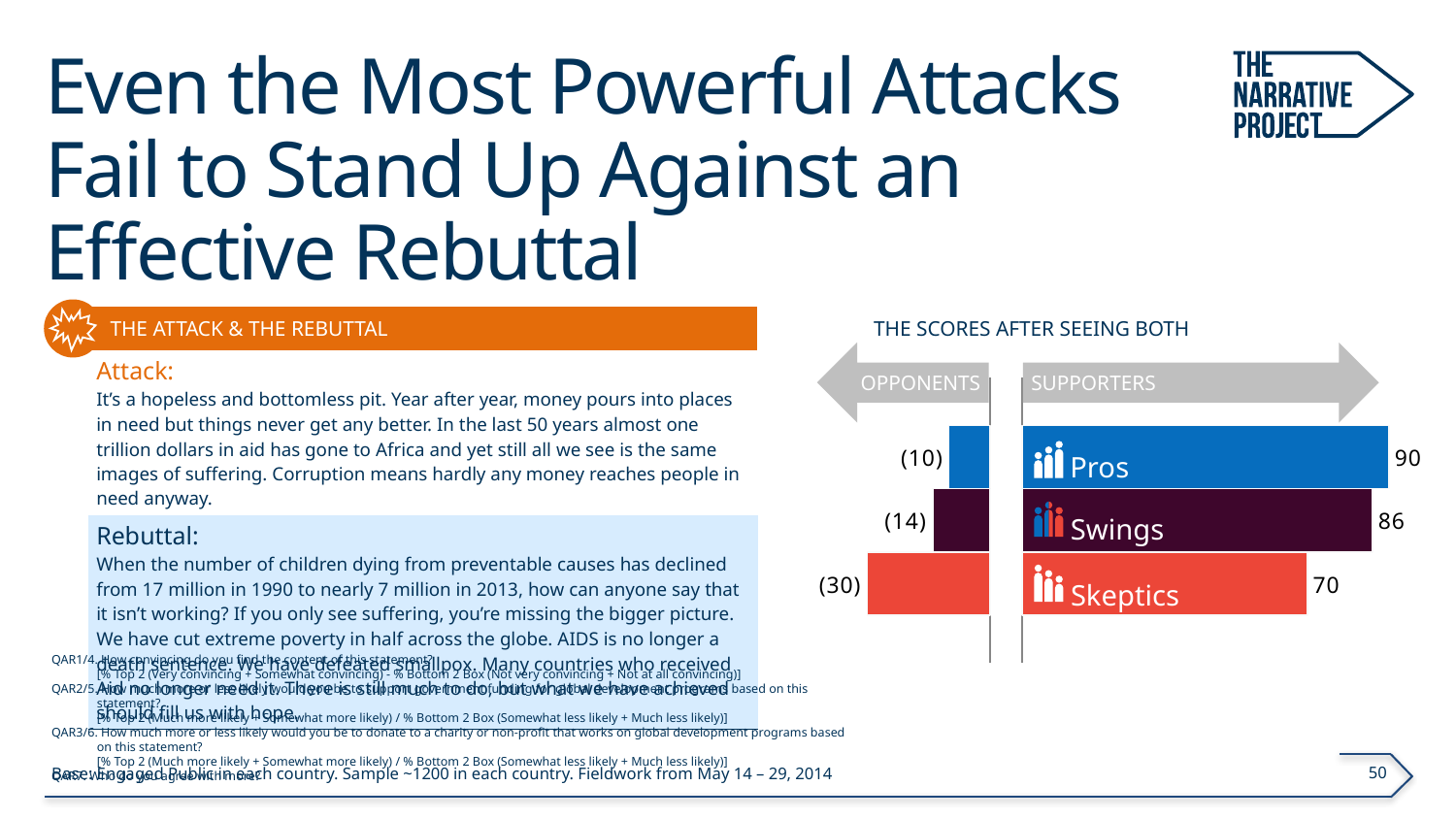
What is the difference between the Supporters scores for Pros and Skeptics? 20 What is the Supporters score for Skeptics? 70 Which group has the lowest Supporters score? Skeptics What is the title of the chart? THE SCORES AFTER SEEING BOTH Which group has the largest Opponents bar? Skeptics What is the Opponents value shown for Pros? (10) What is the Supporters score for Swings? 86 How many groups are shown in the chart? 3 What is the Supporters score for Pros? 90 Which group has the highest Supporters score? Pros What is the Opponents value shown for Skeptics? (30) Which is larger, the Supporters score for Swings or for Skeptics? Swings